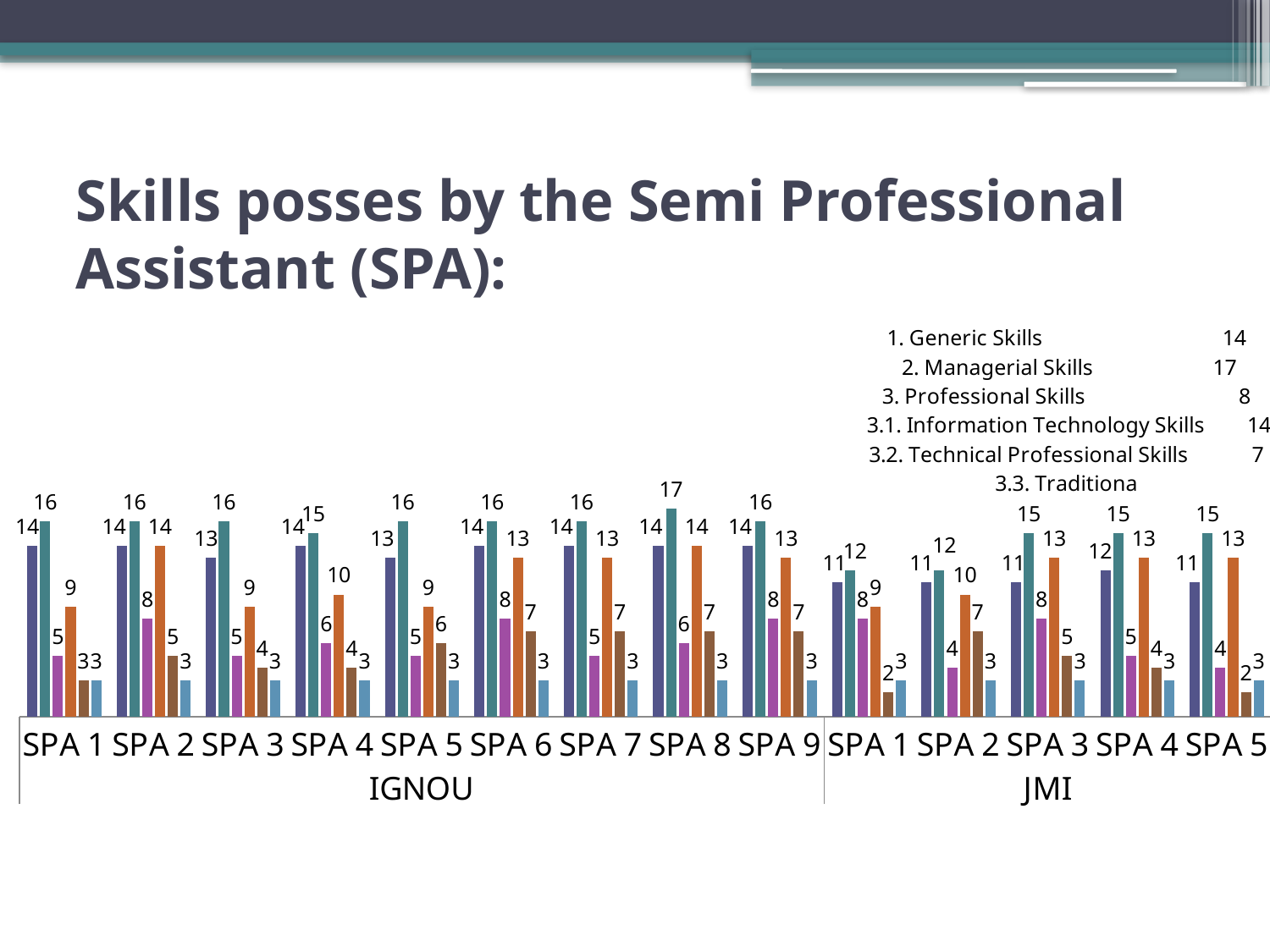
What is the lowest value labelled anywhere on the chart? 2 For SPA 1 under IGNOU, what is the difference between the teal bar (16) and the purple bar (5)? 11 How many SPA categories are shown under the IGNOU group on the x axis? 9 What is the value of the orange (fourth) bar for SPA 2 under IGNOU? 14 How many SPA categories are shown under the JMI group on the x axis? 5 What is the value of the teal (second) bar for SPA 8 under IGNOU? 17 What is the title of the slide containing the chart? Skills posses by the Semi Professional Assistant (SPA): How many bars are plotted for each SPA category? 6 What is the value of the dark blue (first) bar for SPA 4 under JMI? 12 What is the highest value labelled anywhere on the chart? 17 Which is larger: the dark blue bar for SPA 1 under IGNOU or the dark blue bar for SPA 1 under JMI? SPA 1 under IGNOU What kind of chart is shown on the slide? bar chart